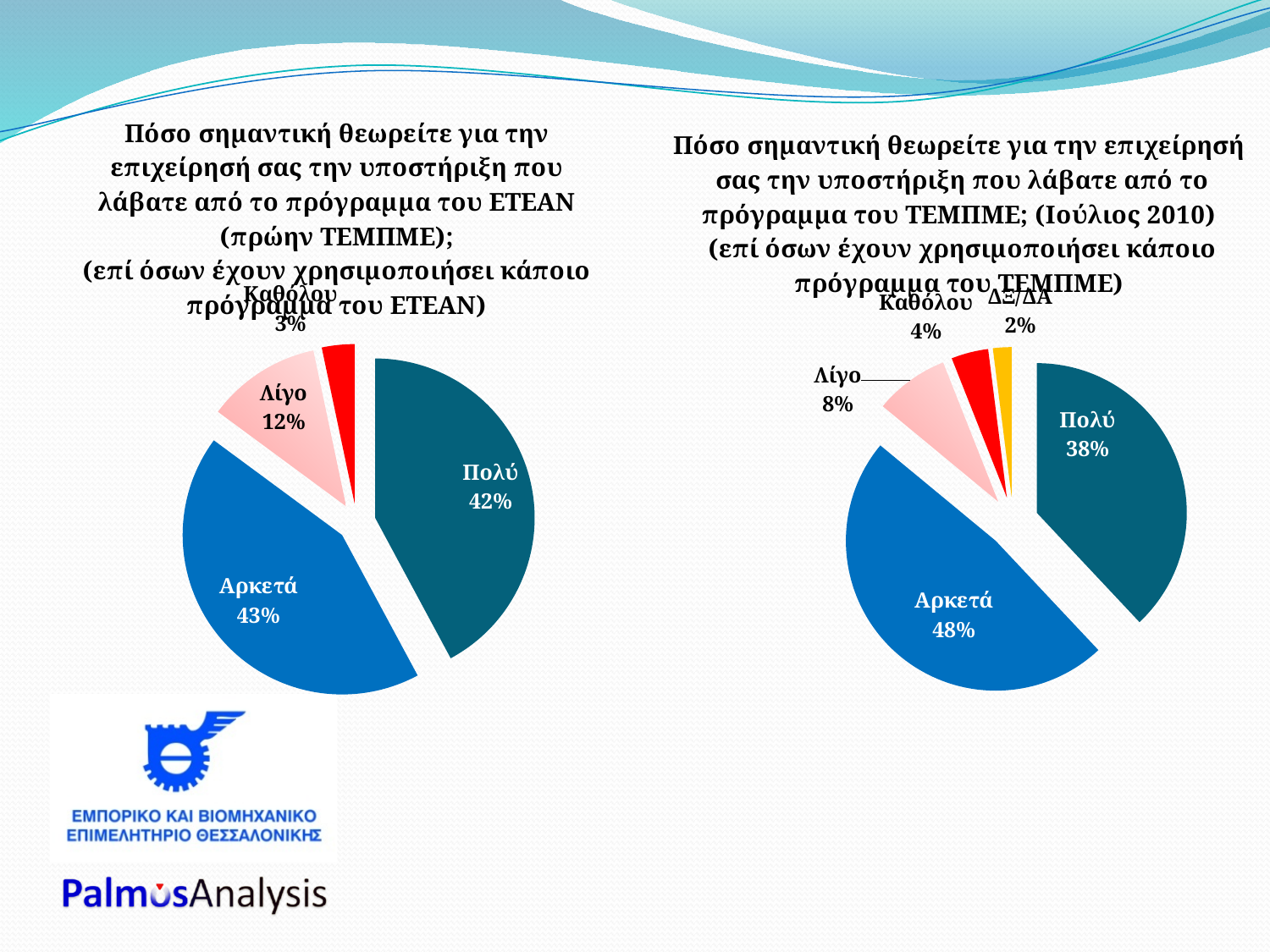
In the right pie chart (ΤΕΜΠΜΕ, Ιούλιος 2010), what percentage of respondents answered Αρκετά? 48% In the left pie chart (ETEAN), what is the difference in percentage points between Λίγο and Καθόλου? 9 percentage points Which is larger in the right pie chart (ΤΕΜΠΜΕ, Ιούλιος 2010): the share for Λίγο or the share for Καθόλου? Λίγο In the right pie chart (ΤΕΜΠΜΕ, Ιούλιος 2010), which response has the smallest share? ΔΞ/ΔΑ In the left pie chart (ETEAN), what percentage of respondents answered Καθόλου? 3% In the left pie chart (ETEAN), what percentage of respondents answered Πολύ? 42% In the left pie chart (ETEAN), which response has the smallest share? Καθόλου In the right pie chart (ΤΕΜΠΜΕ, Ιούλιος 2010), what percentage of respondents answered ΔΞ/ΔΑ? 2% What type of chart is used on the left side of the slide (ETEAN)? Pie chart In the right pie chart (ΤΕΜΠΜΕ, Ιούλιος 2010), which response has the largest share? Αρκετά How many slices does the right pie chart (ΤΕΜΠΜΕ, Ιούλιος 2010) have? 5 In the right pie chart (ΤΕΜΠΜΕ, Ιούλιος 2010), what is the difference in percentage points between Αρκετά and Πολύ? 10 percentage points